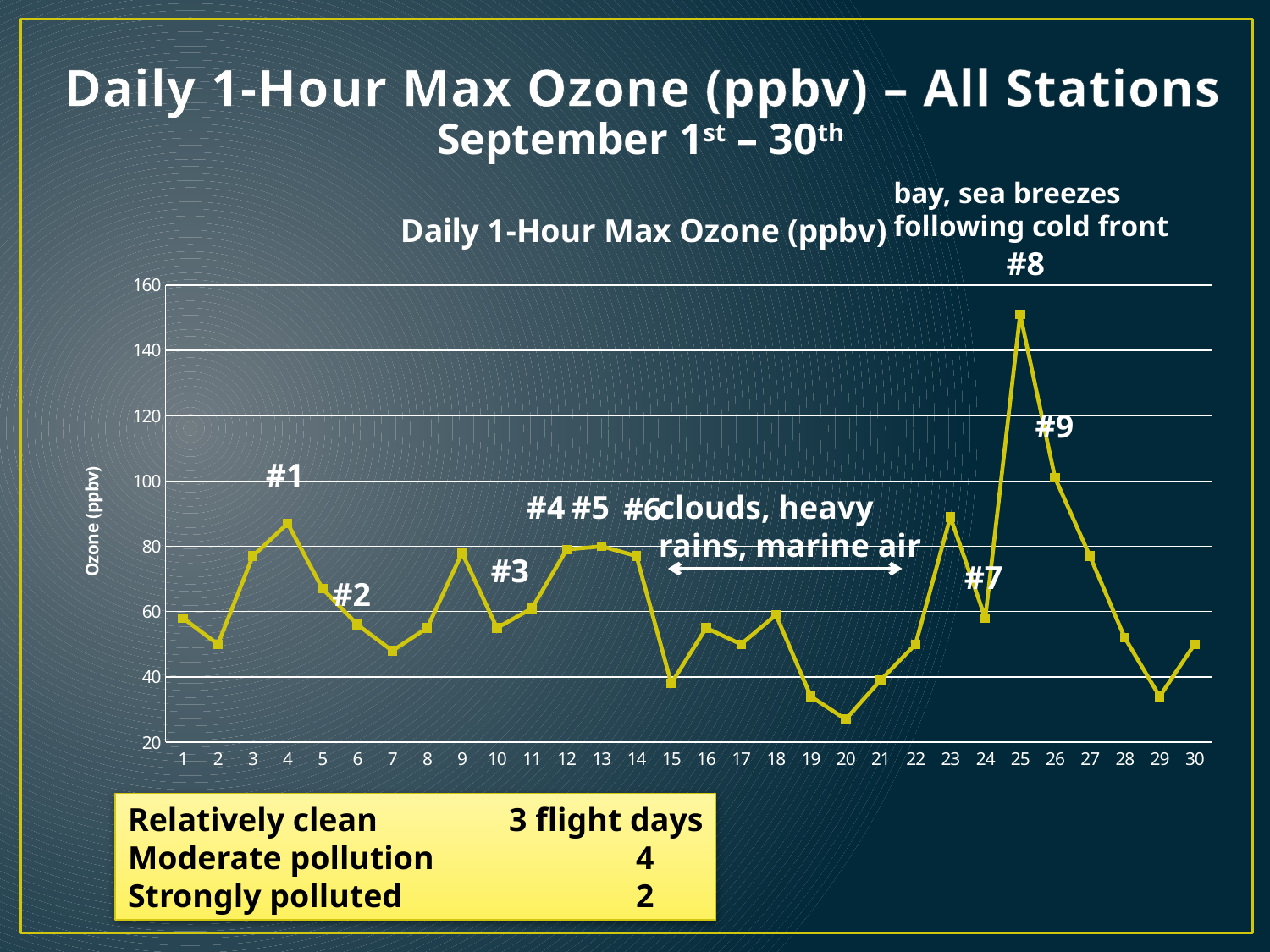
Is the value for day 25 greater or less than 140? greater Is the value for day 20 greater or less than 40? less What is the label on the y axis of the chart? Ozone (ppbv) Is the value for day 7 greater or less than 60? less Which flight number annotation is placed at the peak on day 25? #8 On which day is the daily 1-hour max ozone lowest? 20 Which day has the larger value, day 25 or day 4? day 25 On which day is the daily 1-hour max ozone highest? 25 What kind of chart is shown on the slide? line chart Do the values rise or fall from day 25 to day 29? fall How many days are plotted on the x axis? 30